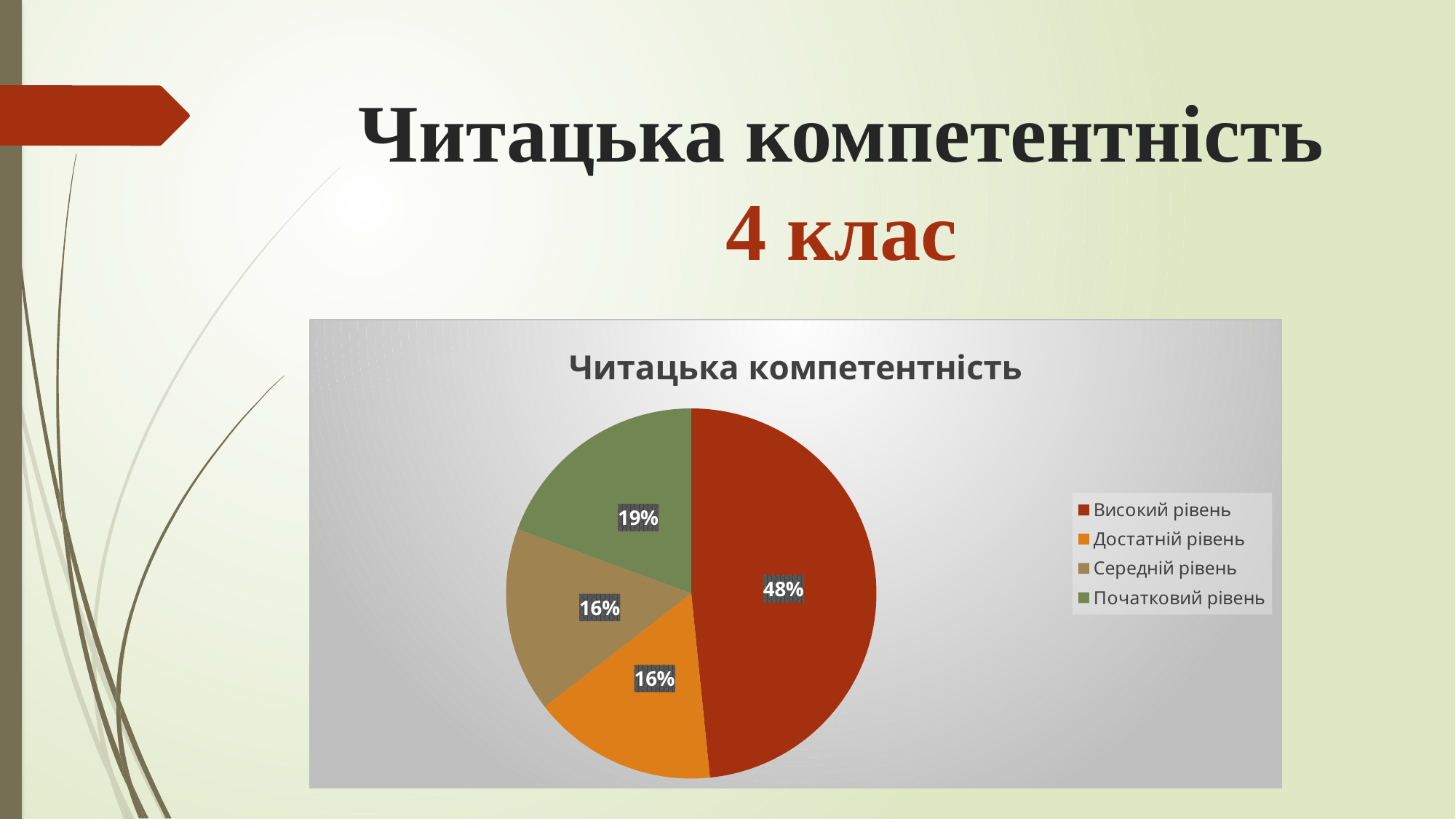
What percentage is shown for Високий рівень? 48% What is the difference in percentage points between Високий рівень and Початковий рівень? 29 What percentage is shown for Початковий рівень? 19% What percentage is shown for Достатній рівень? 16% What colour is the slice for Високий рівень? red What percentage is shown for Середній рівень? 16% Which category has the largest slice of the pie? Високий рівень How many categories does the legend list? 4 How many slices does the pie chart have? 4 What is the title of the chart? Читацька компетентність What kind of chart is shown on the slide? pie chart Which is larger, the slice for Початковий рівень or the slice for Достатній рівень? Початковий рівень